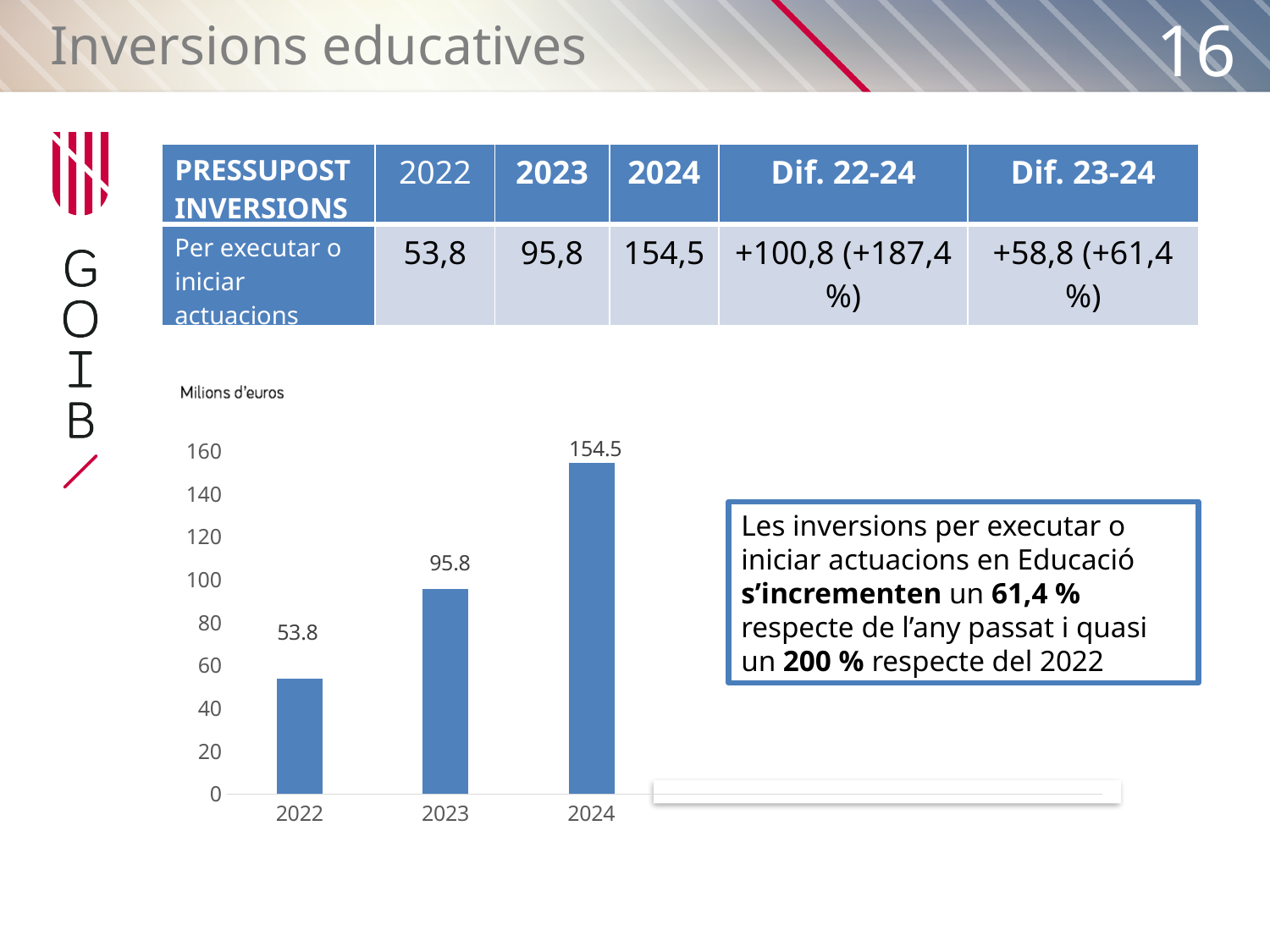
What is the difference between the 2023 and 2022 values in the bar chart? 42 What is the value shown for 2022 in the bar chart? 53.8 How many bars are plotted in the chart? 3 What is the value shown for 2024 in the bar chart? 154.5 Is the value for 2024 in the bar chart greater or less than 140? greater Which year has the highest value in the bar chart? 2024 What type of chart is shown on the slide? bar chart Which is larger in the bar chart, the value for 2023 or the value for 2022? 2023 Which year has the lowest value in the bar chart? 2022 Do the values in the bar chart rise or fall from 2022 to 2024? rise What unit label is shown above the bar chart? Milions d'euros What is the value shown for 2023 in the bar chart? 95.8